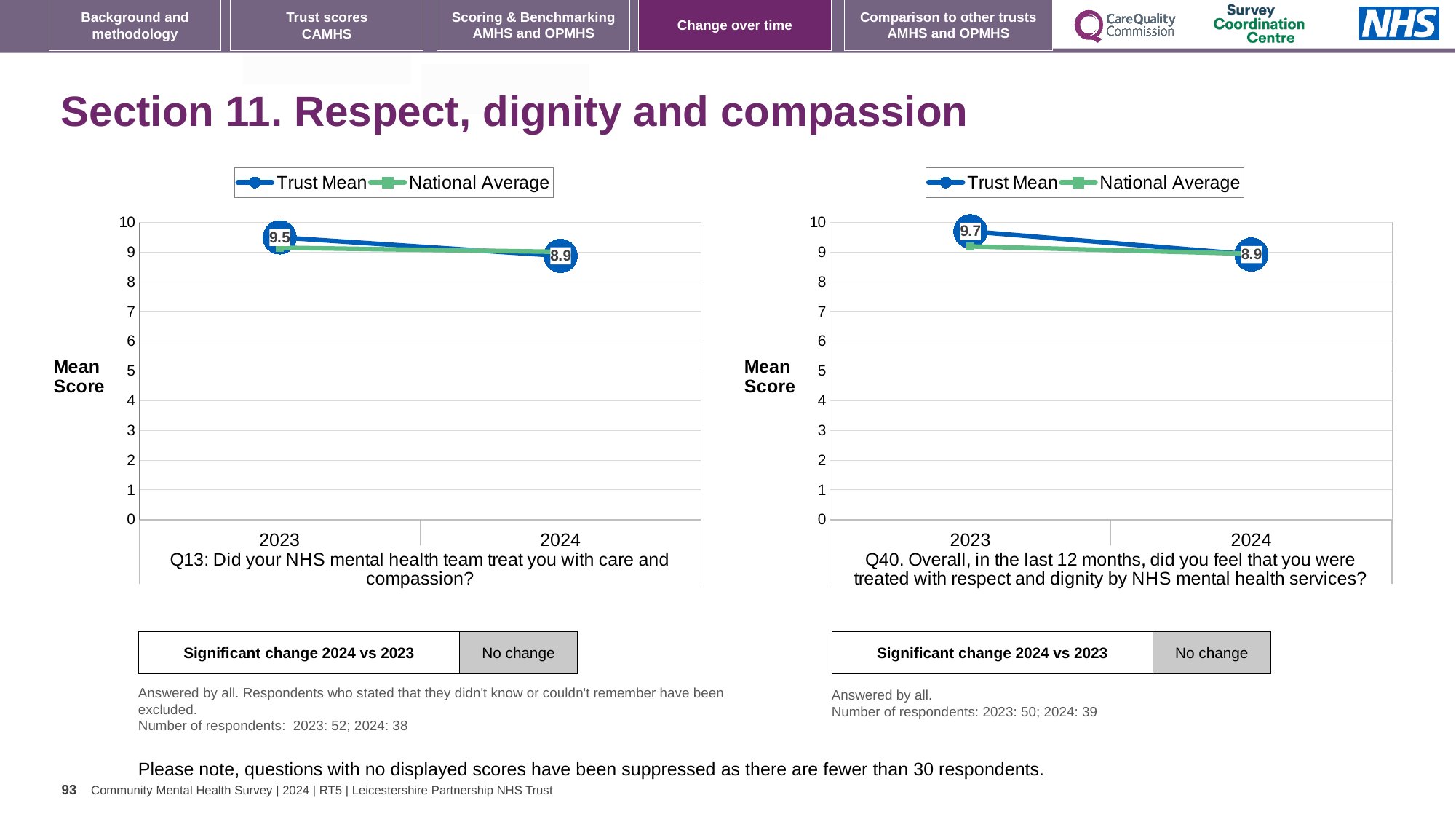
In the right chart (Q40), what is the Trust Mean for 2024? 8.9 In the right chart (Q40), what is the difference between the Trust Mean in 2023 and in 2024? 0.8 In the right chart (Q40), is the National Average for 2023 greater or less than 8? greater In the right chart (Q40), what is the Trust Mean for 2023? 9.7 In the left chart (Q13), by how much did the Trust Mean fall from 2023 to 2024? 0.6 In the left chart (Q13), which year has the higher Trust Mean, 2023 or 2024? 2023 How many years are plotted on the x axis of the left chart (Q13)? 2 In the left chart (Q13), what is the Trust Mean for 2024? 8.9 How many series does the legend of the right chart (Q40) list? 2 In the left chart (Q13), what is the Trust Mean for 2023? 9.5 In the right chart (Q40), does the Trust Mean rise or fall from 2023 to 2024? fall What kind of chart is used on the left of the slide (Q13)? line chart